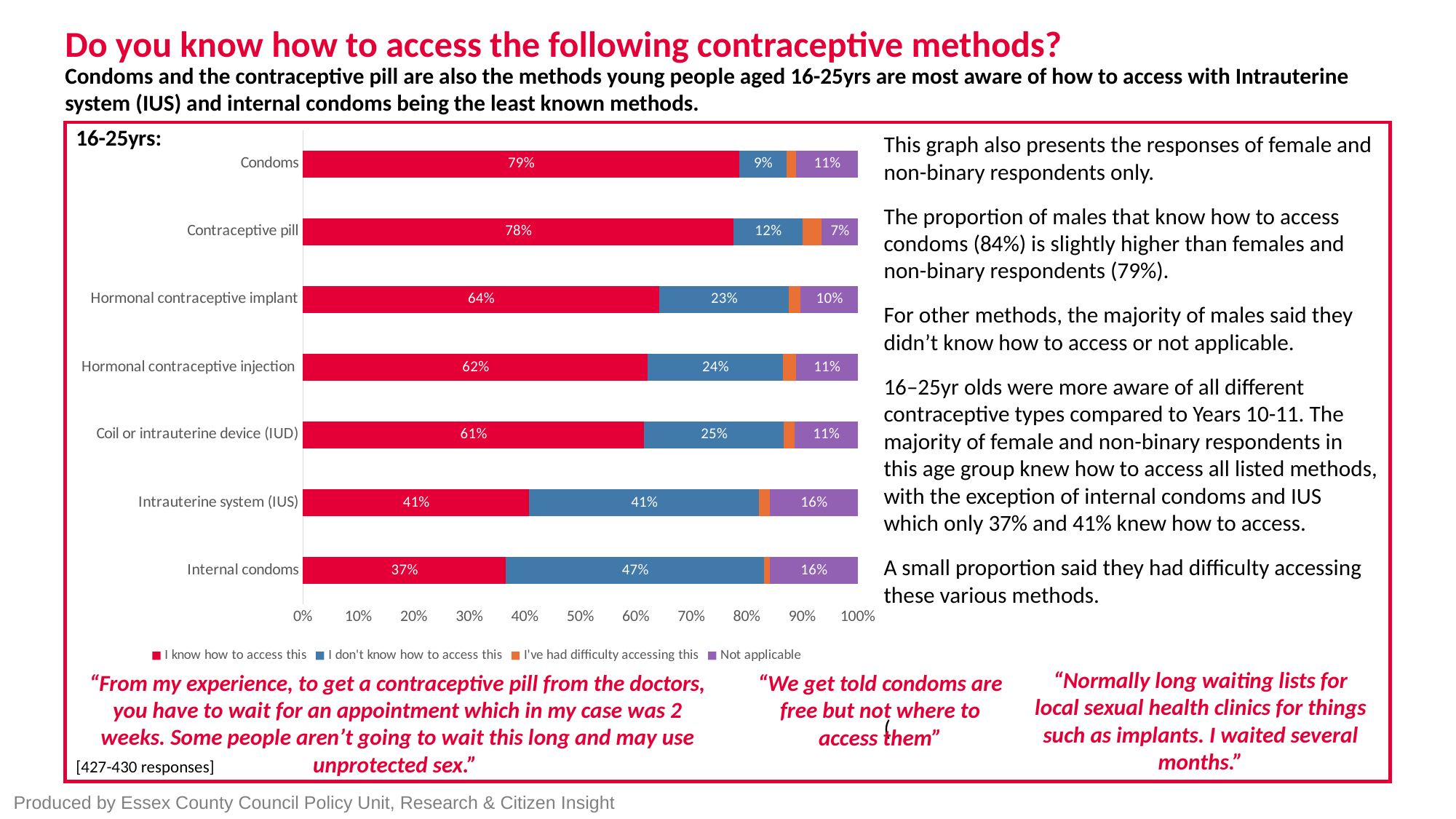
Which contraceptive method has the highest percentage of respondents who know how to access it? Condoms How many response categories does the legend list? 4 Which contraceptive method has the lowest percentage of respondents who know how to access it? Internal condoms What type of chart is shown on the slide? Stacked bar chart What is the difference between the 'I know how to access this' percentages for Condoms and Internal condoms? 42% What percentage of 16-25yr respondents said they know how to access condoms? 79% What percentage of respondents said they don't know how to access internal condoms? 47% Which response category is shown in red on the chart? I know how to access this What is the 'Not applicable' percentage for the Intrauterine system (IUS)? 16% What age group does the chart cover? 16-25yrs How many contraceptive methods are listed on the chart? 7 Which has a larger 'I don't know how to access this' share: Hormonal contraceptive implant or Coil or intrauterine device (IUD)? Coil or intrauterine device (IUD)